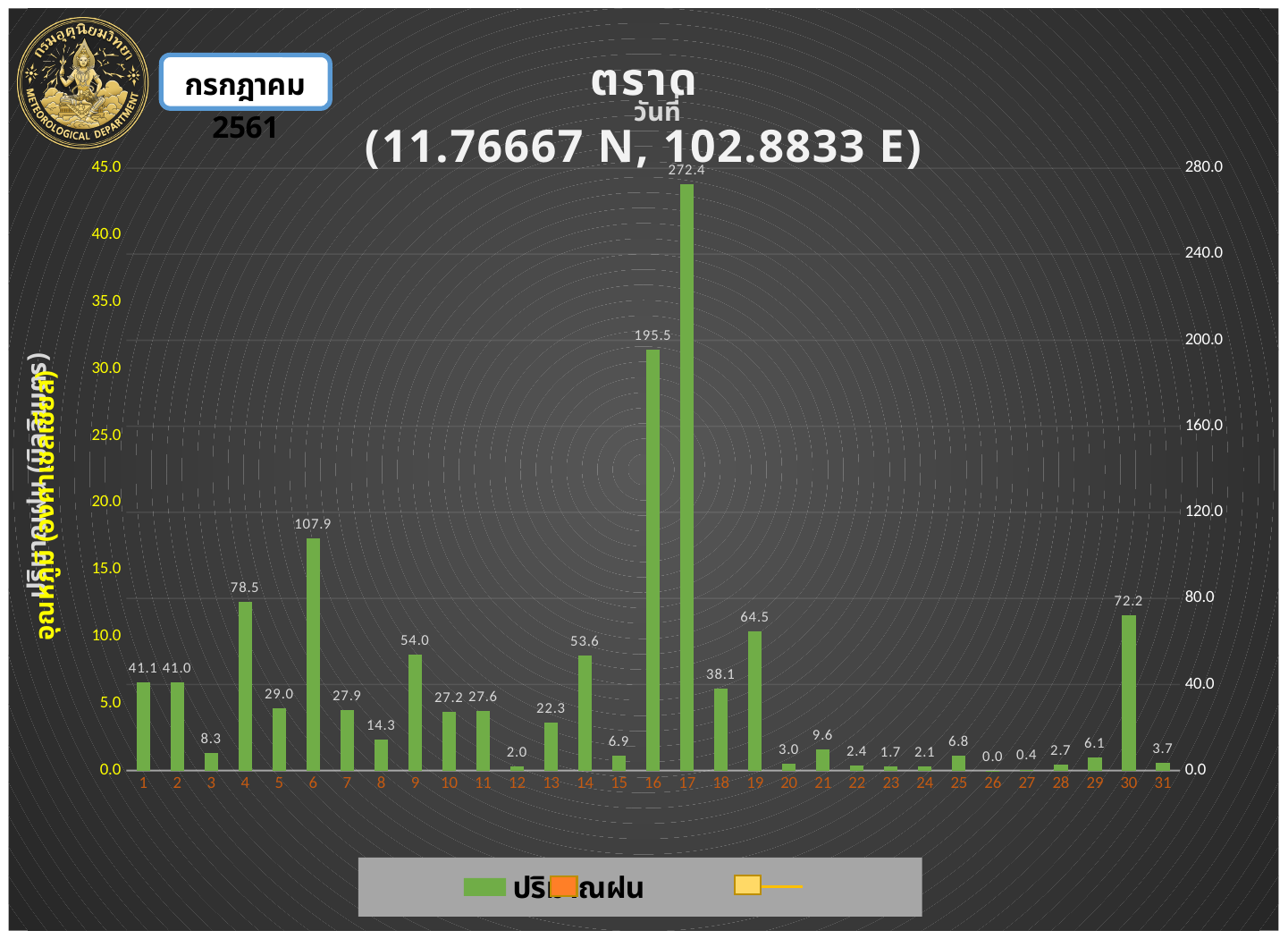
Which is larger, the value for day 9 or the value for day 14? day 9 What coordinates are given in the chart title? 11.76667 N, 102.8833 E What is the value for day 17? 272.4 What is the value for day 26? 0.0 What is the value for day 30? 72.2 How many days (categories) are shown on the x axis? 31 Which day has the highest value? 17 What is the value for day 6? 107.9 What kind of chart is shown? bar chart Which day has the lowest value? 26 What is the difference between the values for day 4 and day 30? 6.3 What is the difference between the values for day 17 and day 16? 76.9